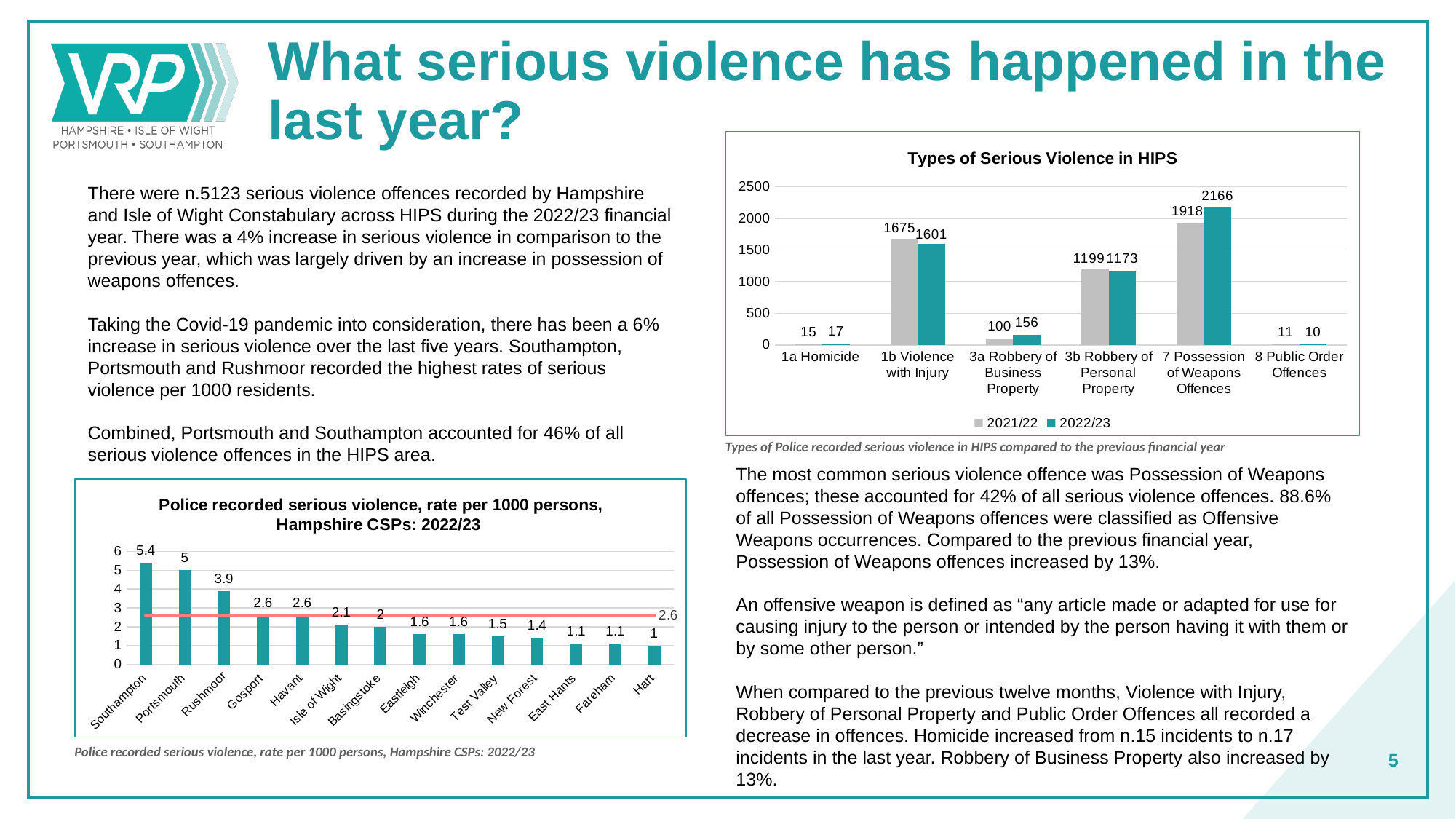
In the 'Types of Serious Violence in HIPS' chart, is the 2021/22 value for 3b Robbery of Personal Property larger or smaller than the 2022/23 value? larger In the 'Types of Serious Violence in HIPS' chart, what is the difference between the 2021/22 and 2022/23 values for 3a Robbery of Business Property? 56 In the 'Types of Serious Violence in HIPS' chart, how many series does the legend list? 2 In the 'Police recorded serious violence, rate per 1000 persons' chart, what is the value for Rushmoor? 3.9 In the 'Types of Serious Violence in HIPS' chart, what is the 2022/23 value for 7 Possession of Weapons Offences? 2166 In the 'Police recorded serious violence, rate per 1000 persons' chart, how many CSPs are shown on the x axis? 14 In the 'Types of Serious Violence in HIPS' chart, what is the 2021/22 value for 1b Violence with Injury? 1675 In the 'Types of Serious Violence in HIPS' chart, which category has the highest 2022/23 value? 7 Possession of Weapons Offences In the 'Police recorded serious violence, rate per 1000 persons' chart, which CSP has the highest rate? Southampton In the 'Types of Serious Violence in HIPS' chart, which category has the lowest 2022/23 value? 8 Public Order Offences In the 'Police recorded serious violence, rate per 1000 persons' chart, which CSP has the lowest rate? Hart What kind of chart is the 'Police recorded serious violence, rate per 1000 persons' chart? Combination bar and line chart